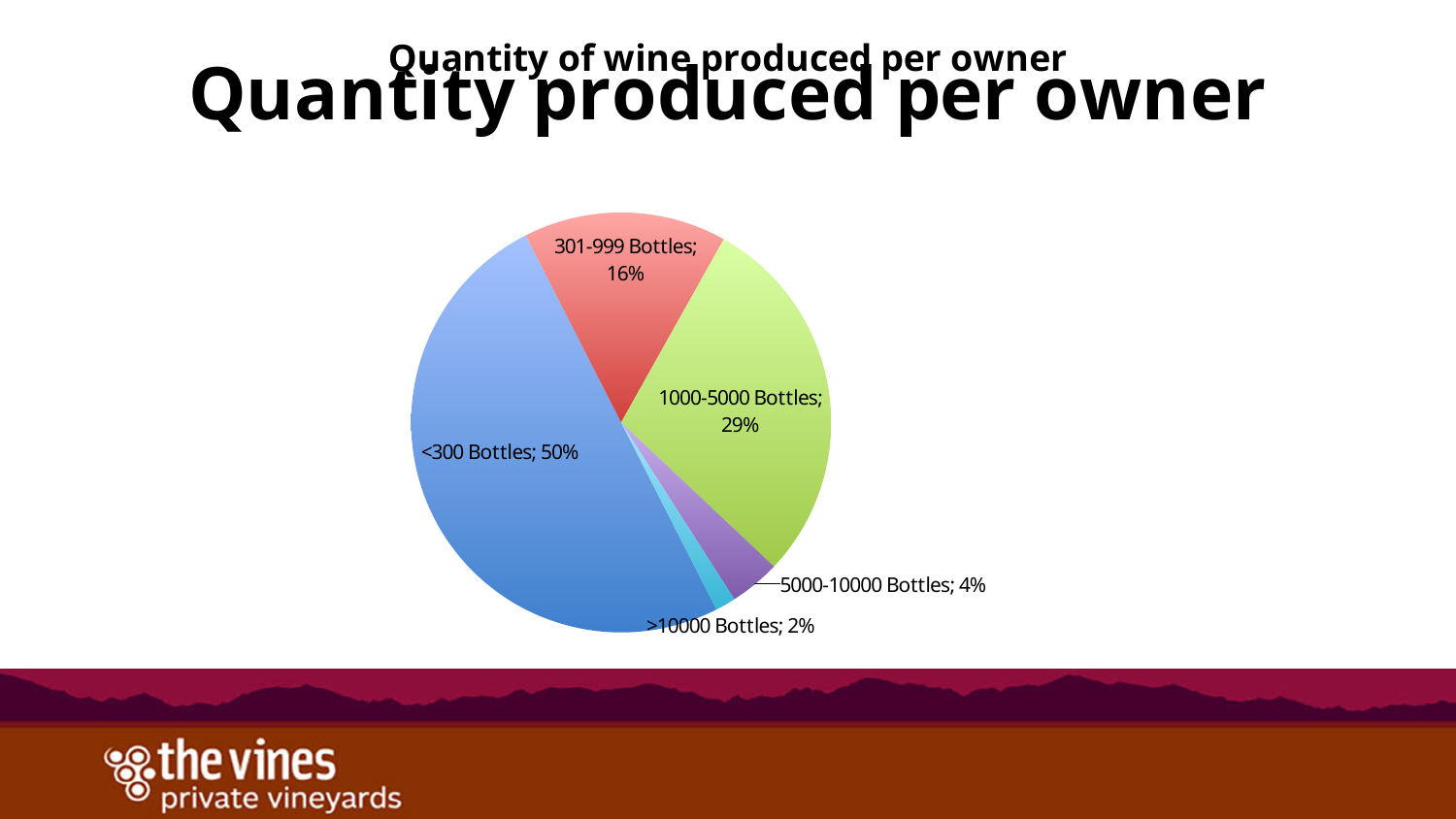
Which category has the smallest share of the pie? >10000 Bottles What share of owners produce 5000-10000 Bottles? 4% What share of owners produce 301-999 Bottles? 16% What share of owners produce >10000 Bottles? 2% What share of owners produce 1000-5000 Bottles? 29% What is the difference in percentage points between the <300 Bottles and 1000-5000 Bottles slices? 21 Which category has the largest share of the pie? <300 Bottles How many categories are shown in the pie chart? 5 What is the title of the chart? Quantity produced per owner Which is larger, the share for 301-999 Bottles or for 1000-5000 Bottles? 1000-5000 Bottles What share of owners produce <300 Bottles? 50% What kind of chart is shown on the slide? Pie chart